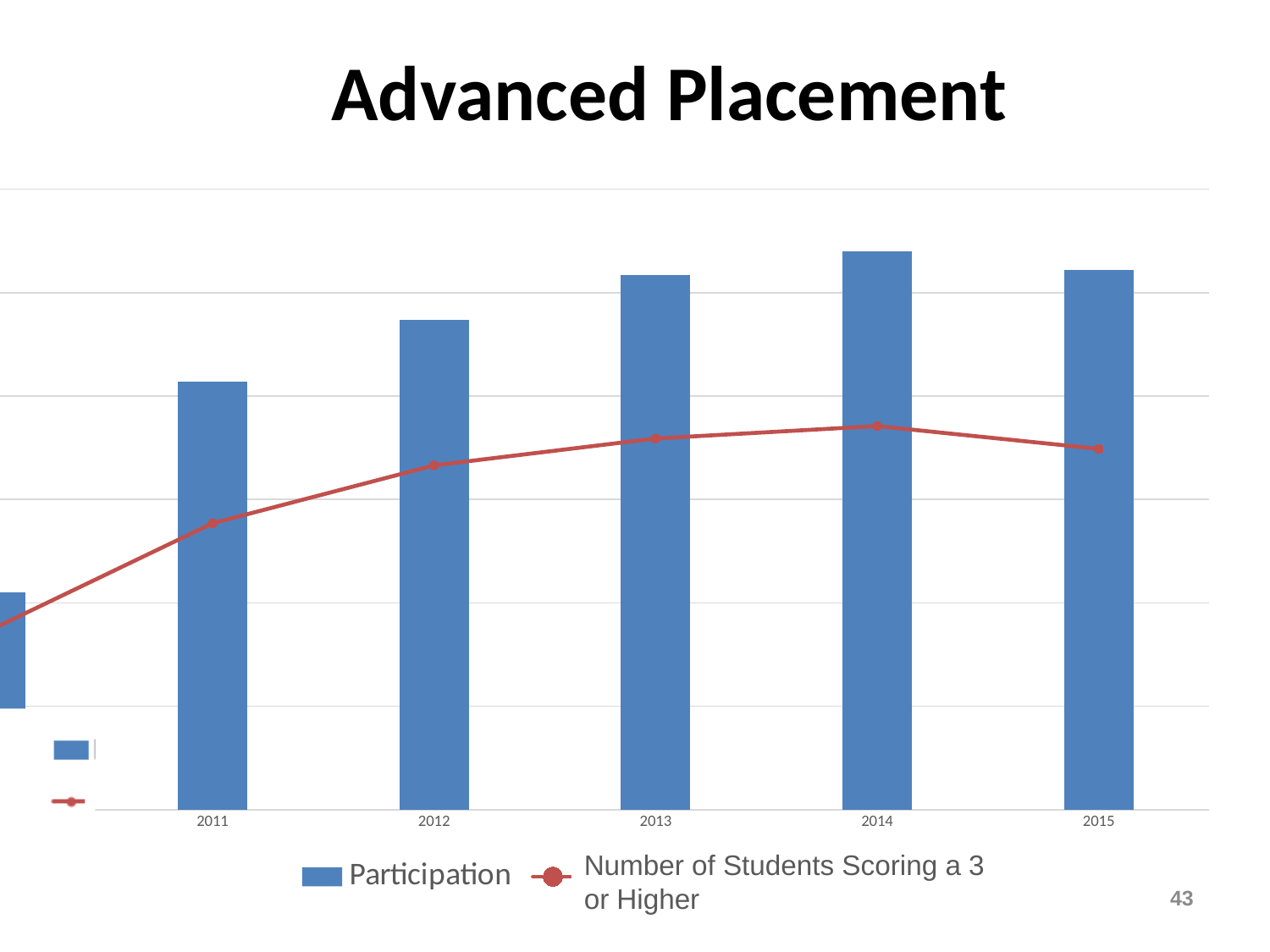
Which labelled year has the lowest Participation bar? 2011 What are the two series named in the legend? Participation; Number of Students Scoring a 3 or Higher How does Participation change from 2011 to 2014? It rises each year What is the title of the slide containing the chart? Advanced Placement Is the Number of Students Scoring a 3 or Higher larger in 2011 or in 2015? 2015 How many series does the legend list? 2 Which labelled year has the lowest value for Number of Students Scoring a 3 or Higher? 2011 Does the Number of Students Scoring a 3 or Higher rise or fall from 2014 to 2015? Falls How many labelled years are shown on the x axis? 5 Which labelled year has the highest Participation bar? 2014 Is Participation higher in 2012 or in 2013? 2013 What kind of chart is shown on the slide? A combined bar and line chart